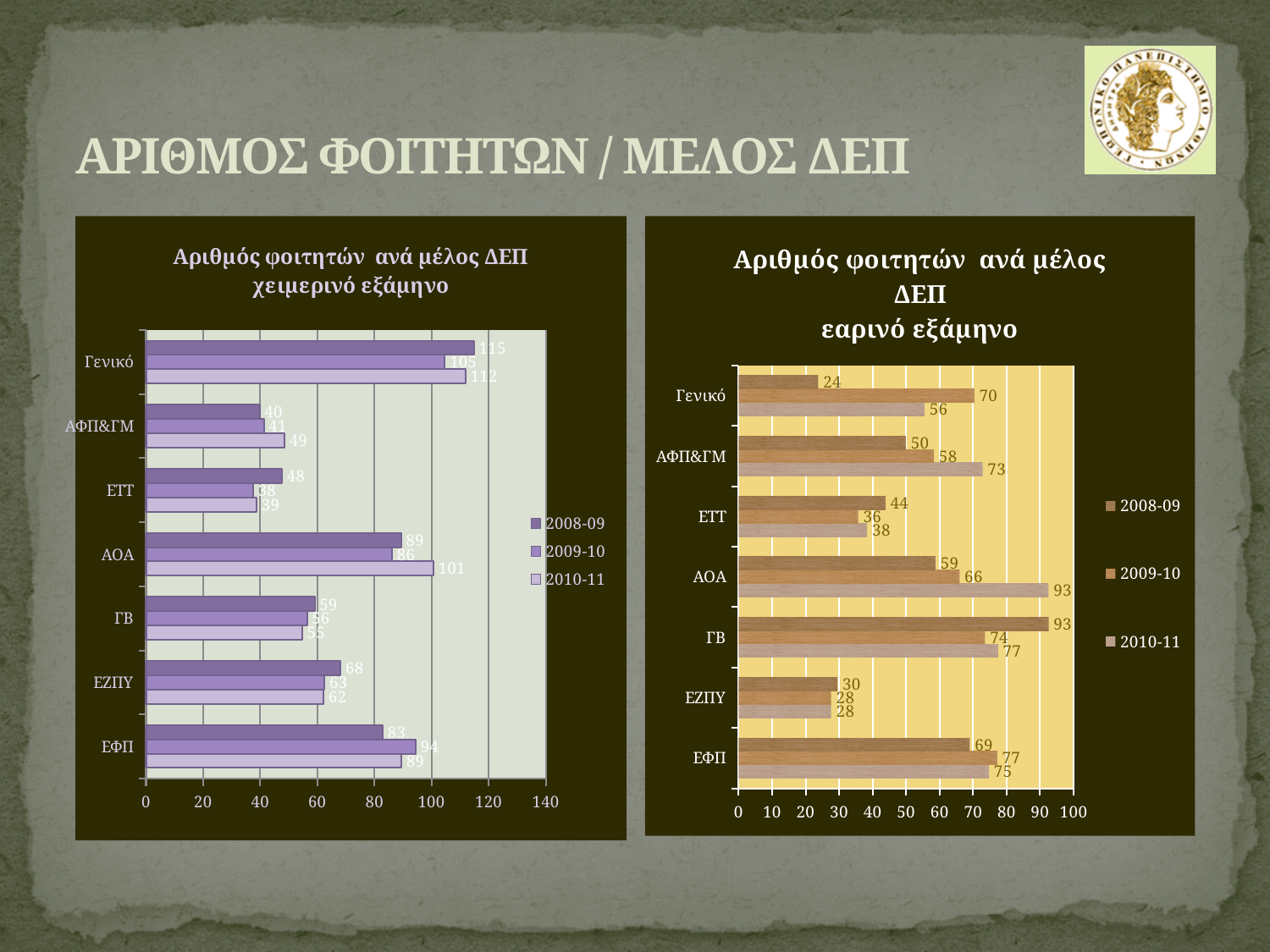
How many series does the legend of the right chart (εαρινό εξάμηνο) list? 3 What kind of chart is the right chart (εαρινό εξάμηνο)? Bar chart How many categories are shown on the y axis of the left chart (χειμερινό εξάμηνο)? 7 In the right chart (εαρινό εξάμηνο), which category has the lowest value for 2010-11? ΕΖΠΥ In the right chart (εαρινό εξάμηνο), what is the value for ΑΦΠ&ΓΜ in 2010-11? 73 In the right chart (εαρινό εξάμηνο), what is the value for Γενικό in 2008-09? 24 In the right chart (εαρινό εξάμηνο), what is the difference between the 2010-11 and 2008-09 values for ΑΟΑ? 34 In the left chart (χειμερινό εξάμηνο), what is the value for ΑΟΑ in 2010-11? 101 In the left chart (χειμερινό εξάμηνο), what is the value for Γενικό in 2008-09? 115 In the left chart (χειμερινό εξάμηνο), which category has the highest value for 2009-10? Γενικό In the left chart (χειμερινό εξάμηνο), what is the difference between the 2009-10 and 2008-09 values for ΕΦΠ? 11 In the right chart (εαρινό εξάμηνο), which is larger for ΓΒ: the 2008-09 value or the 2010-11 value? 2008-09